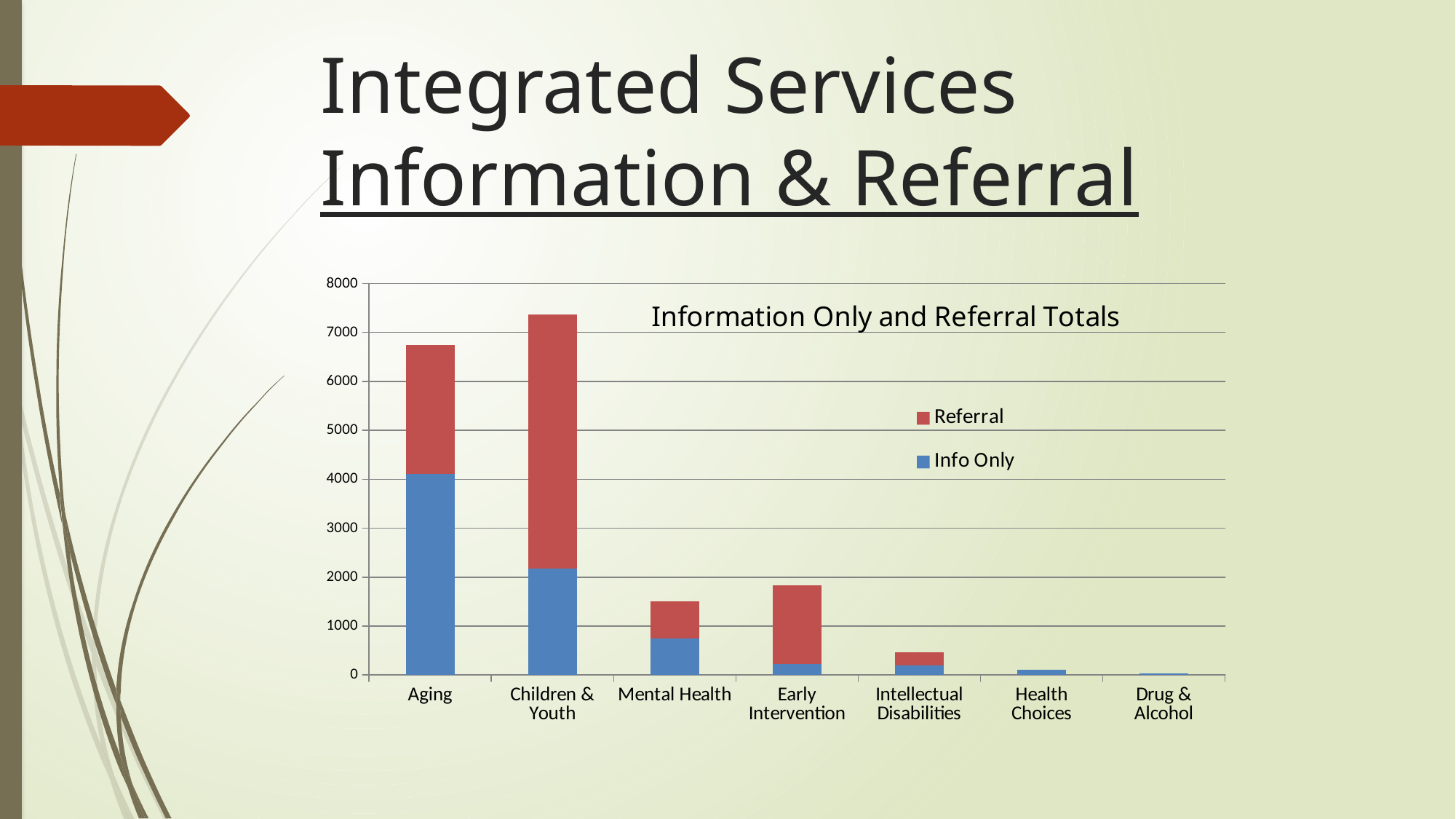
Is the total bar for Mental Health greater or less than 2000? less Which category has the highest total bar? Children & Youth What kind of chart is shown on the slide? bar chart Which has the larger Info Only value, Aging or Children & Youth? Aging Which has the larger total bar, Aging or Children & Youth? Children & Youth Is the total bar for Aging greater or less than 6000? greater What is the title of the chart? Information Only and Referral Totals Is the Info Only value for Aging greater or less than 3000? greater How many series does the chart's legend list? 2 Which has the larger total bar, Mental Health or Early Intervention? Early Intervention How many categories are shown along the x axis of the chart? 7 Which category has the lowest total bar? Drug & Alcohol